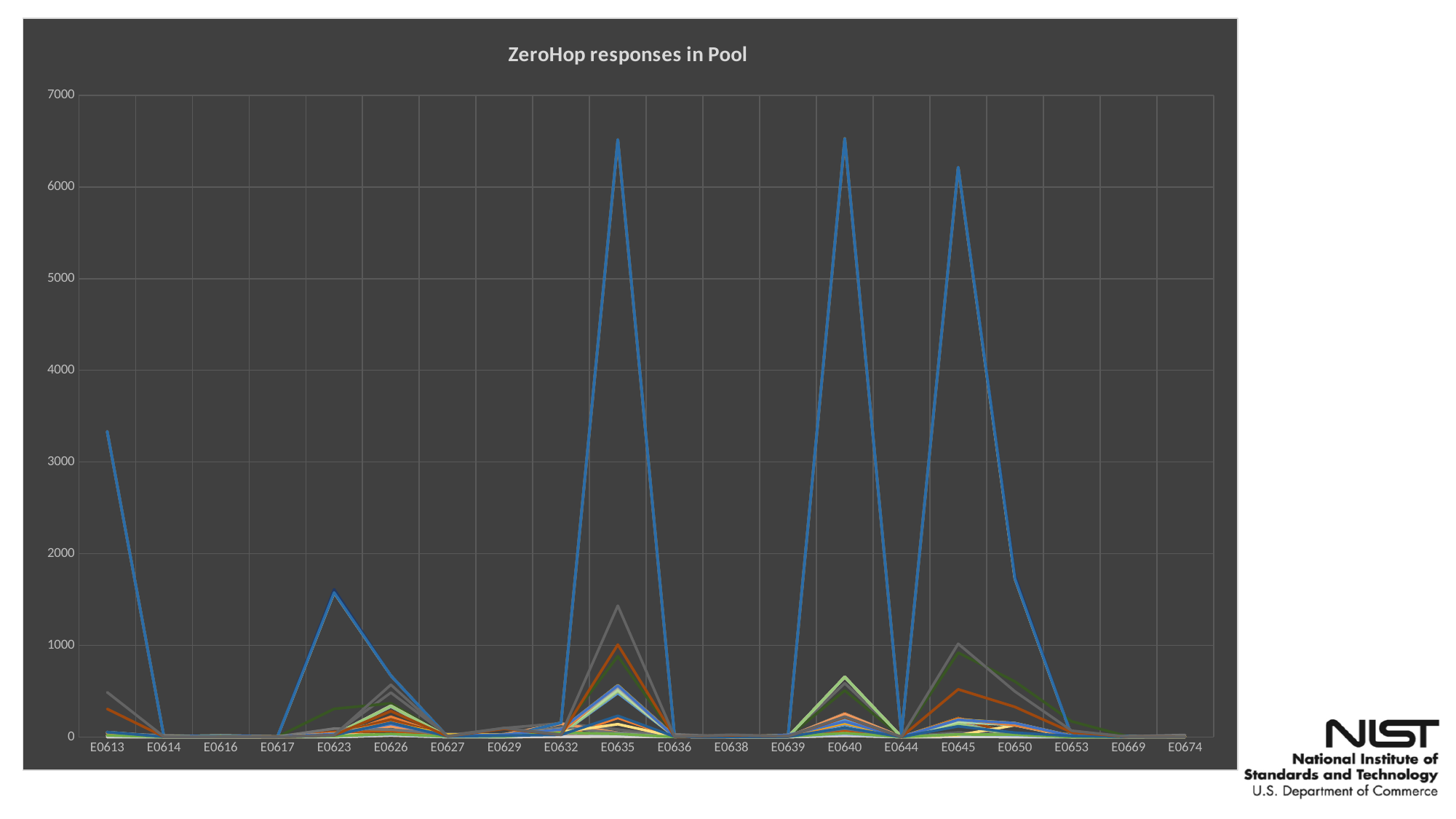
Does the top line rise or fall from E0613 to E0614? fall Is the highest value plotted at E0623 greater or less than 2000? less Is the highest value plotted at E0645 greater or less than 6000? greater What is the title of the chart? ZeroHop responses in Pool Does the top line rise or fall from E0645 to E0653? fall Is the highest value plotted at E0613 greater or less than 3000? greater What kind of chart is shown on the slide? line chart How many categories are shown along the x axis of the chart? 20 What is the highest value shown on the y axis of the chart? 7000